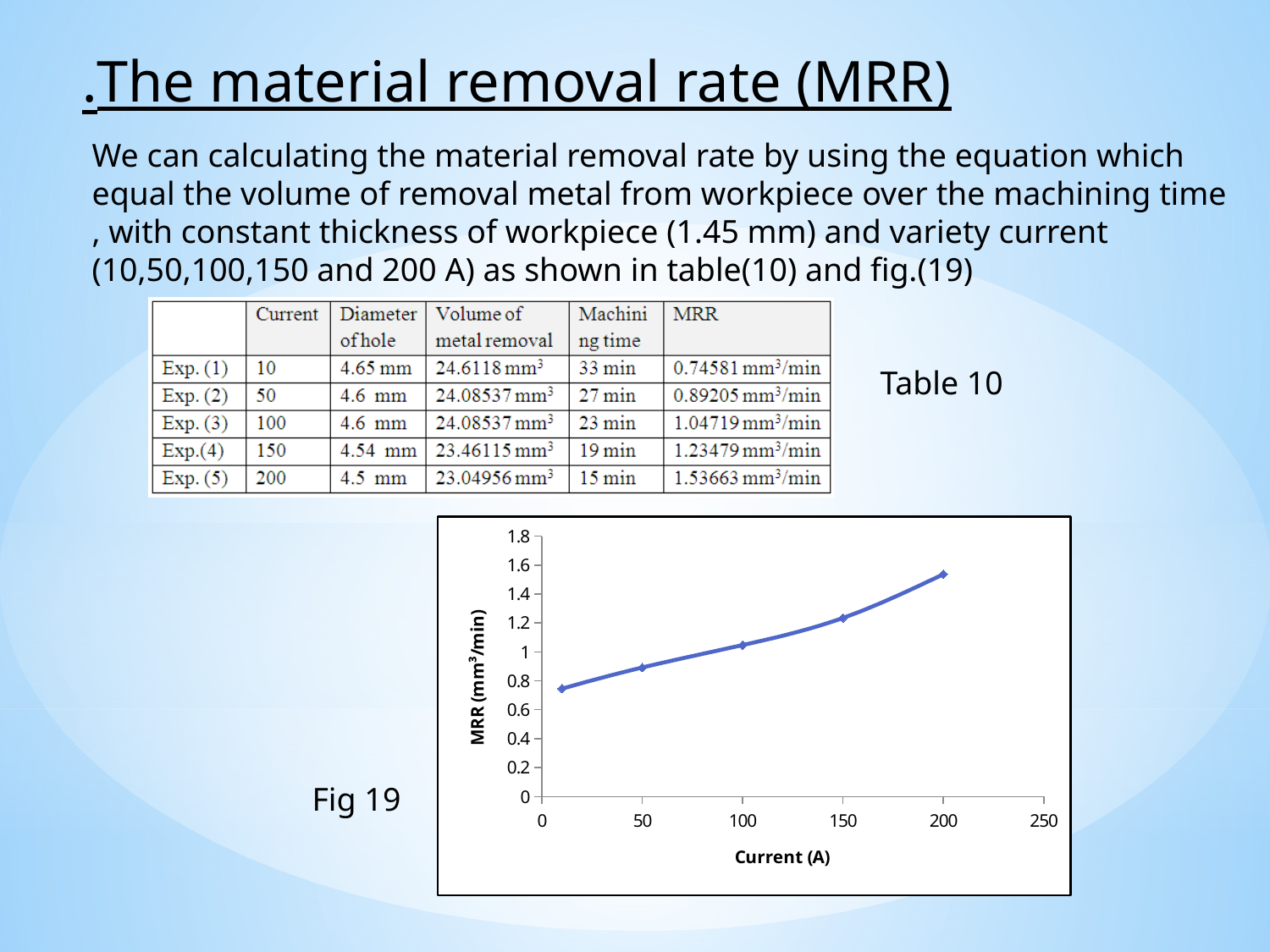
In Fig 19, is the MRR at 50 A greater or less than 1? less In Fig 19, is the MRR at 150 A greater or less than 1.4? less In Fig 19, is the MRR at 200 A greater or less than 1.4? greater In Fig 19, at which current is the MRR lowest? 10 A In Fig 19, how many data points are plotted on the line? 5 What kind of chart is Fig 19? line chart In Fig 19, at which current is the MRR highest? 200 A In Fig 19, does MRR rise or fall as current increases along the x axis? rise What is the label of the x axis in Fig 19? Current (A) What is the label of the y axis in Fig 19? MRR (mm³/min) In Fig 19, which has the larger MRR: 100 A or 200 A? 200 A